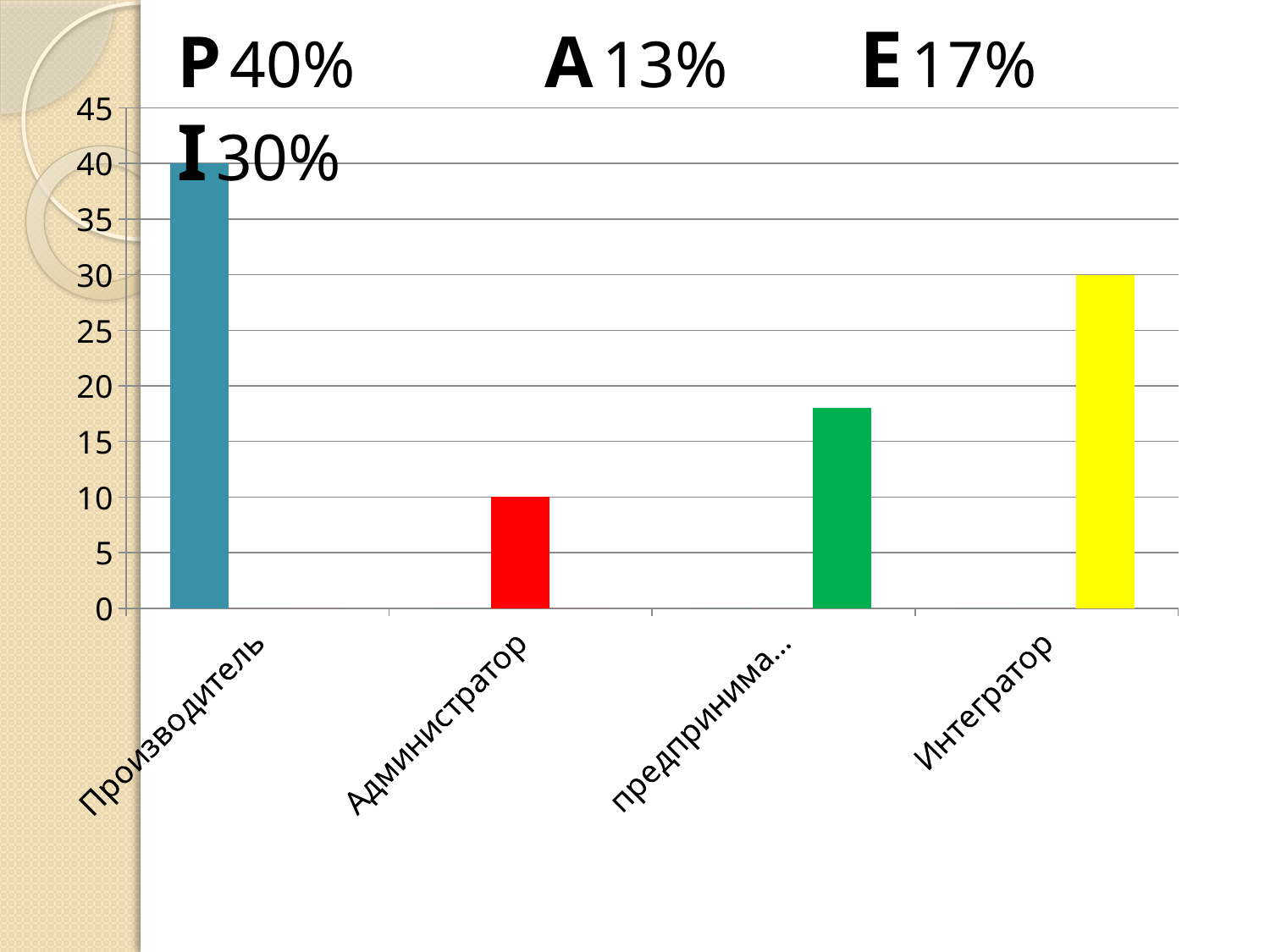
Which category has the highest bar? Производитель What is the difference between the bars for Производитель and Интегратор? 10 What is the value of the bar for Администратор? 10 Which category has the lowest bar? Администратор What is the value of the bar for Интегратор? 30 Is the value of the third bar (предпринима...) greater or less than 20? less What colour is the bar for Интегратор? yellow Which is larger, the bar for Интегратор or the bar for Администратор? Интегратор What kind of chart is shown on the slide? bar chart Is the value of the third bar (предпринима...) greater or less than 15? greater How many categories are shown on the x axis? 4 What is the value of the bar for Производитель? 40